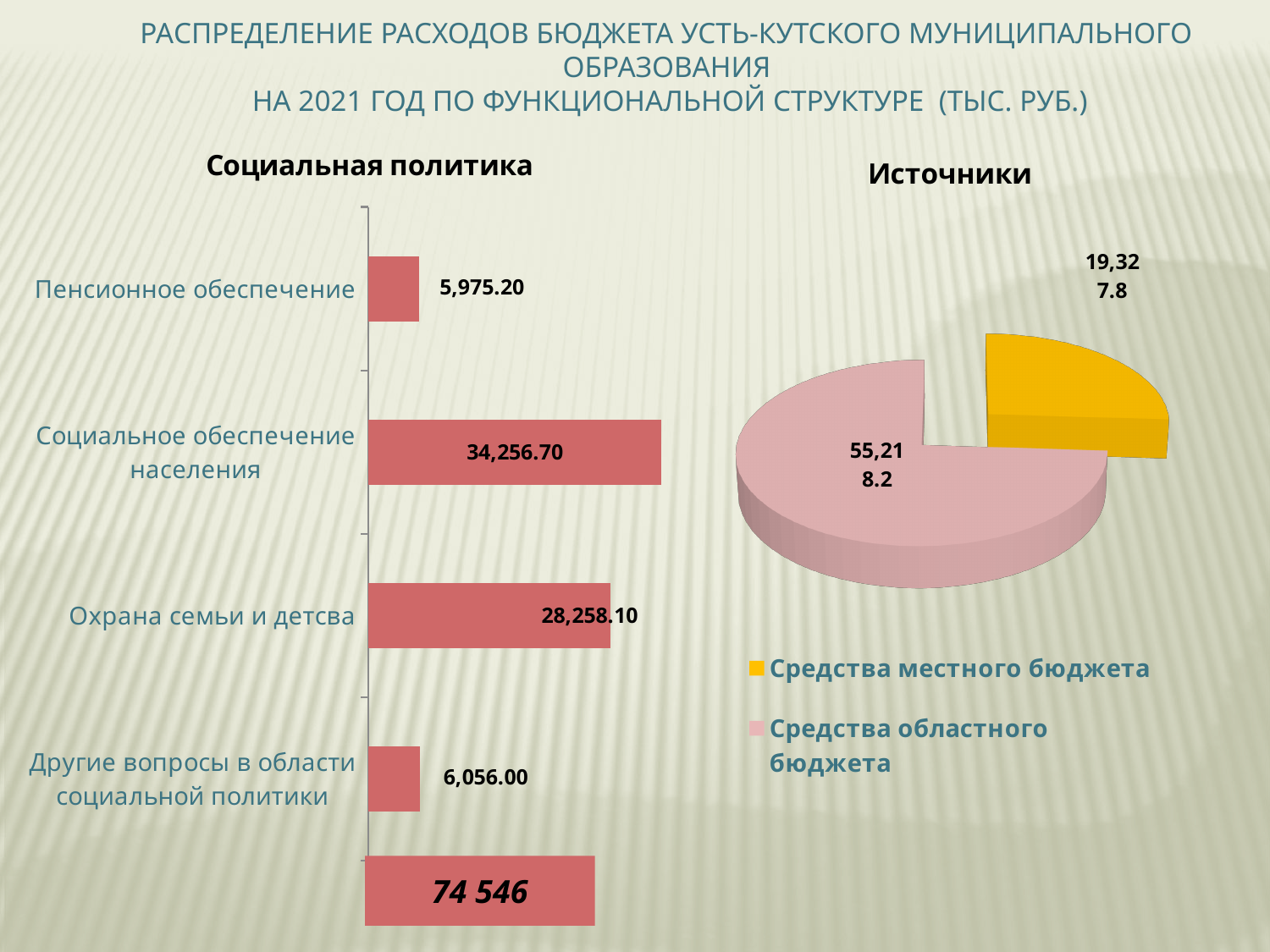
In the "Социальная политика" chart, what is the value for Другие вопросы в области социальной политики? 6,056.00 In the "Социальная политика" chart, what is the value for Пенсионное обеспечение? 5,975.20 In the "Социальная политика" chart, what is the value for Социальное обеспечение населения? 34,256.70 In the "Социальная политика" chart, what is the difference between Социальное обеспечение населения and Охрана семьи и детсва? 5,998.60 In the "Источники" chart, which slice is larger: Средства местного бюджета or Средства областного бюджета? Средства областного бюджета In the "Социальная политика" chart, which category has the highest value? Социальное обеспечение населения In the "Социальная политика" chart, which category has the lowest value? Пенсионное обеспечение What kind of chart is the "Социальная политика" chart? bar chart In the "Социальная политика" chart, what is the value for Охрана семьи и детсва? 28,258.10 In the "Социальная политика" chart, which is larger: Другие вопросы в области социальной политики or Пенсионное обеспечение? Другие вопросы в области социальной политики What kind of chart is the "Источники" chart? pie chart How many entries does the legend of the "Источники" chart list? 2